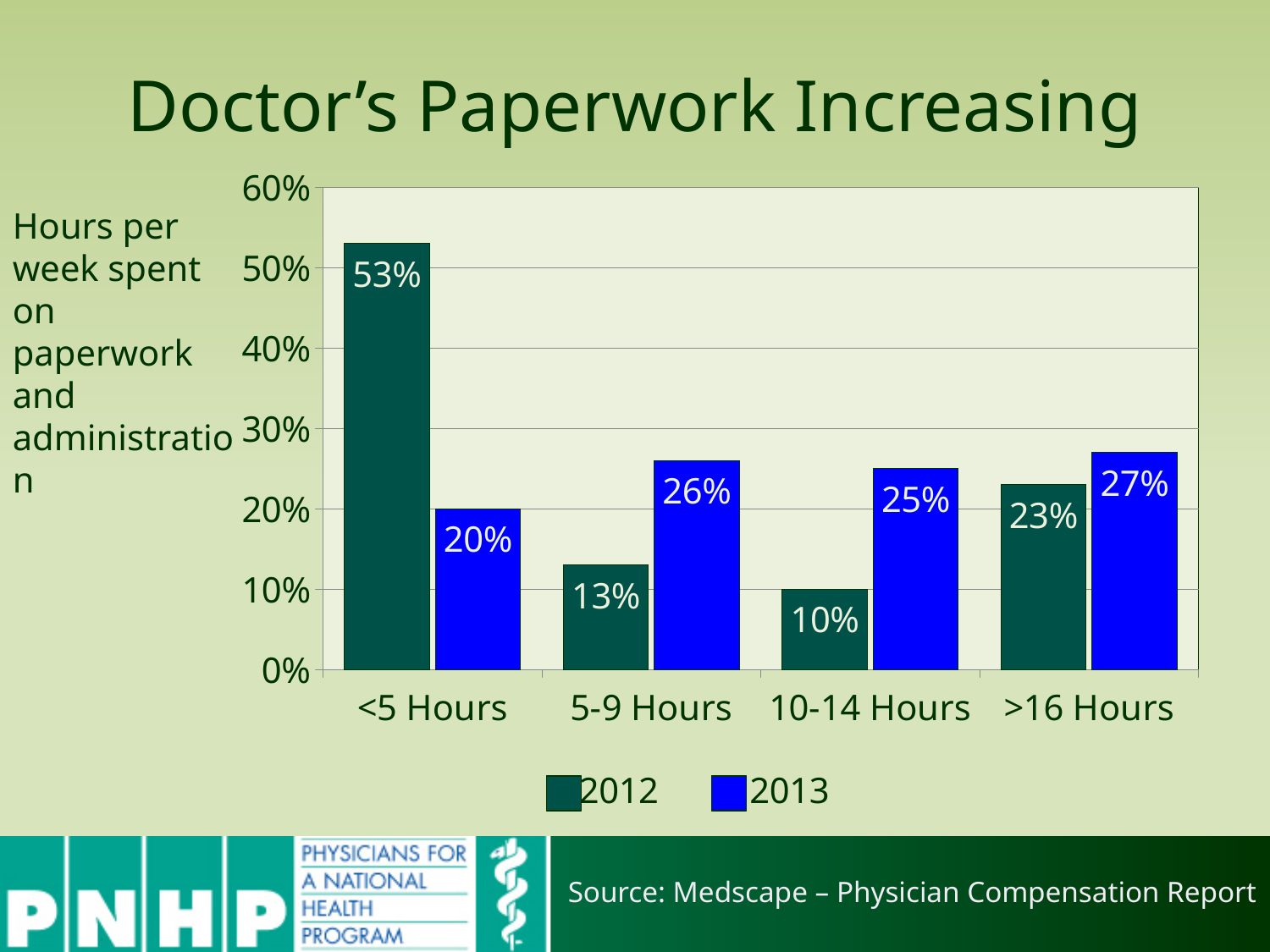
What kind of chart is shown on the slide? Bar chart What is the 2012 value for <5 Hours? 53% How many categories are shown on the x axis? 4 How many series does the legend list? 2 What is the 2012 value for >16 Hours? 23% What is the 2013 value for 10-14 Hours? 25% Which is larger for 5-9 Hours, the 2012 value or the 2013 value? 2013 What is the title of the slide? Doctor's Paperwork Increasing Which category has the lowest 2013 value? <5 Hours Which category has the highest 2012 value? <5 Hours What is the difference between the 2012 and 2013 values for <5 Hours? 33% Do the 2013 values rise or fall from <5 Hours to >16 Hours? Rise